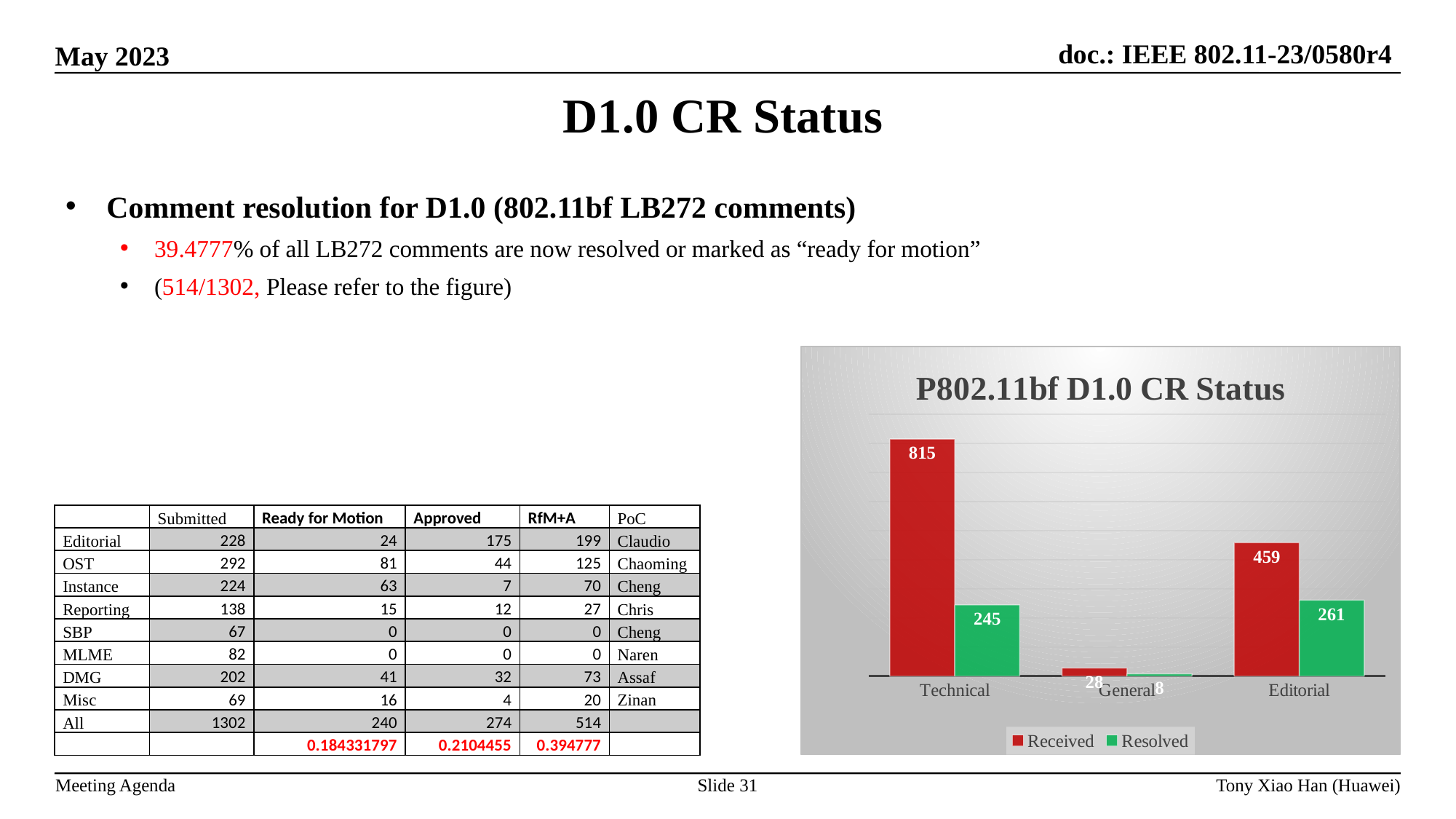
Which category has the lowest Resolved value in the chart? General What is the Received value for Technical in the chart? 815 What is the Received value for General in the chart? 28 What is the difference between Received and Resolved for Technical in the chart? 570 Which colour represents the Resolved series in the chart? green How many series does the chart legend list? 2 What type of chart is shown on the slide? bar chart What is the title of the chart on the slide? P802.11bf D1.0 CR Status Which category has the highest Received value in the chart? Technical What is the Resolved value for Editorial in the chart? 261 Is the Resolved value for Editorial larger or smaller than the Resolved value for Technical? larger How many categories are shown on the x axis of the chart? 3